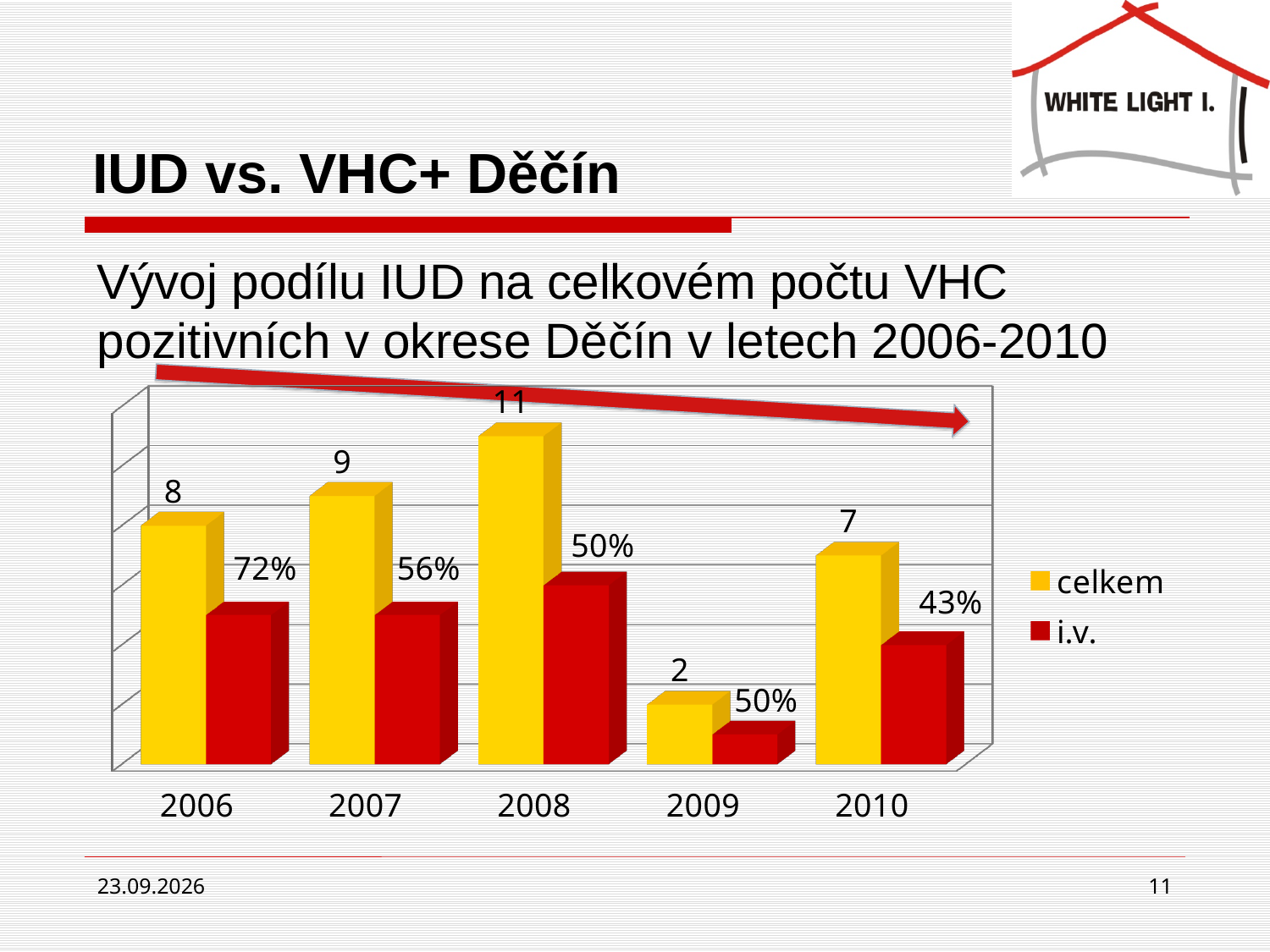
What is the value of the celkem series for 2006? 8 In which year is the celkem value lowest? 2009 What label is shown on the i.v. bar for 2006? 72% What is the value of the celkem series for 2008? 11 In which year is the celkem value highest? 2008 What kind of chart is shown on the slide? bar chart Do the percentage labels on the i.v. bars rise or fall from 2006 to 2010? fall What is the difference between the celkem values for 2008 and 2009? 9 What label is shown on the i.v. bar for 2010? 43% How many series does the legend list? 2 How many years are shown on the x axis? 5 Which year has the larger celkem value, 2007 or 2010? 2007